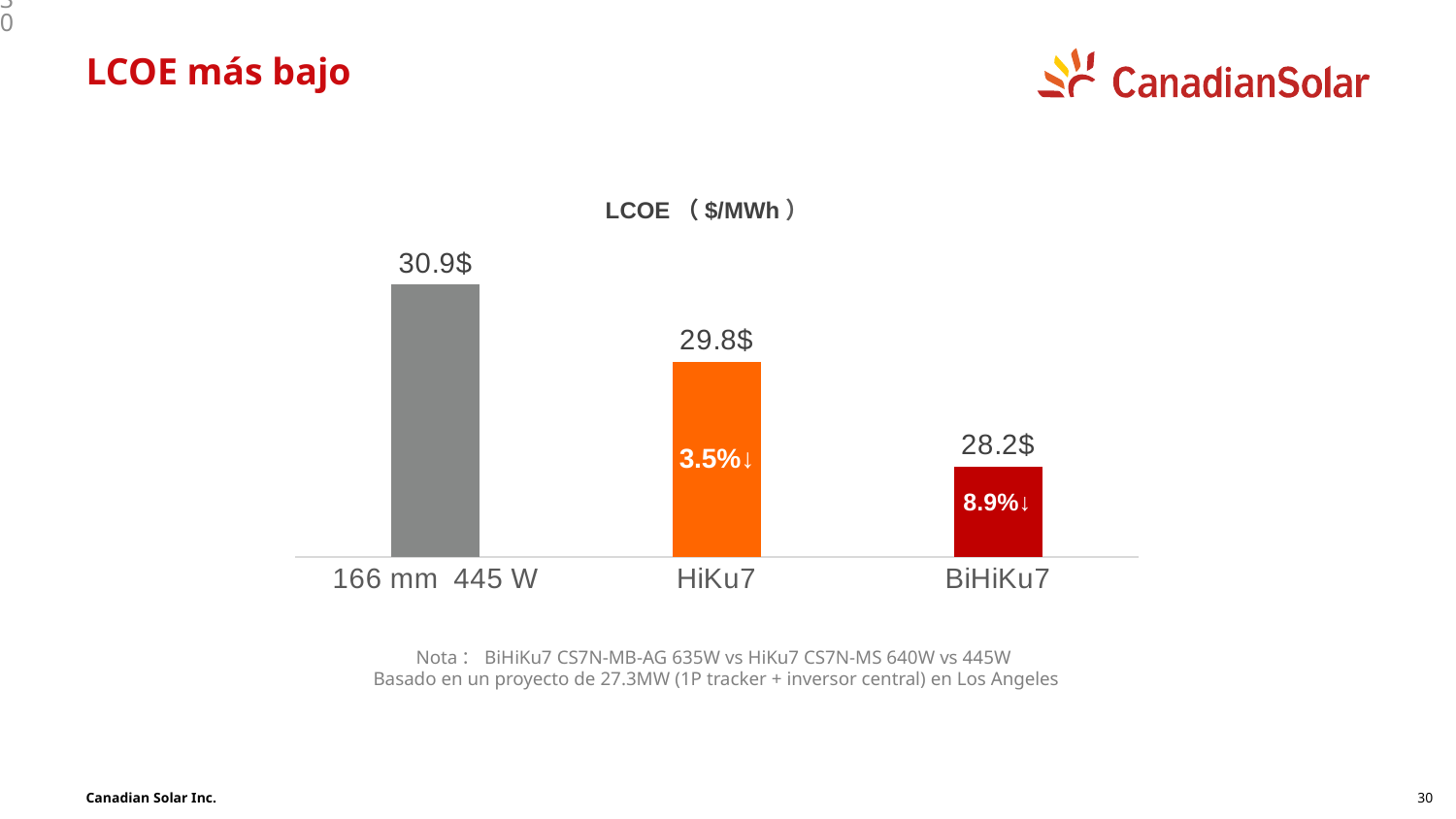
What is the LCOE value shown for BiHiKu7? 28.2$ Do the LCOE values rise or fall from left to right across the categories? Fall What is the LCOE value shown for the 166 mm 445 W module? 30.9$ Which category has the highest LCOE? 166 mm 445 W Which category has the lowest LCOE? BiHiKu7 Which has a larger LCOE, HiKu7 or BiHiKu7? HiKu7 How many categories are shown in the chart? 3 What is the difference in LCOE between the 166 mm 445 W module and BiHiKu7? 2.7$ What percentage reduction is printed inside the BiHiKu7 bar? 8.9%↓ What is the difference in LCOE between HiKu7 and BiHiKu7? 1.6$ What kind of chart is shown on the slide? Bar chart What is the LCOE value shown for HiKu7? 29.8$